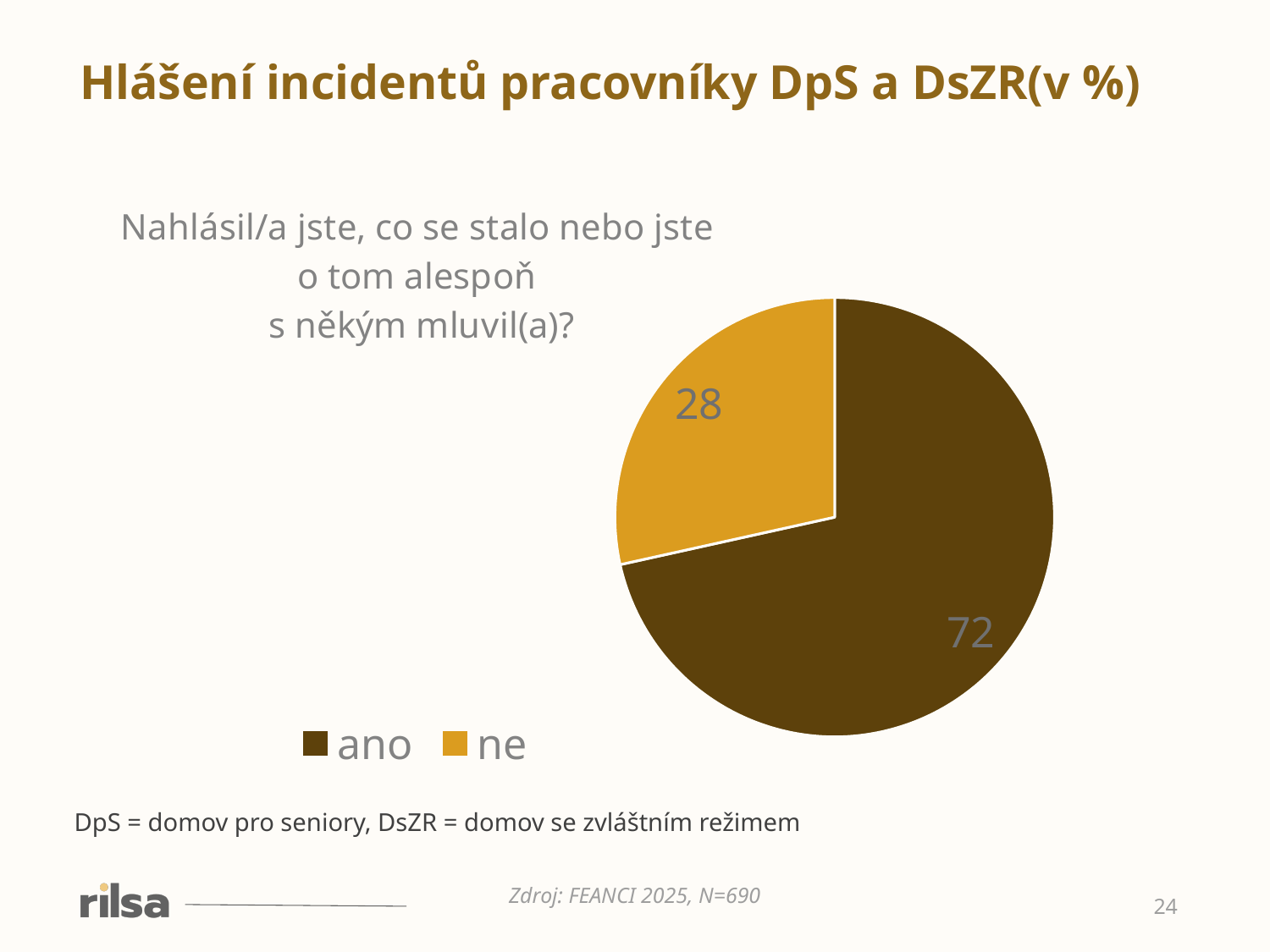
What share of the pie does the "ne" slice represent? 28% Which colour represents "ne" in the pie chart? orange/gold What is the title of the slide containing the pie chart? Hlášení incidentů pracovníky DpS a DsZR(v %) What value is shown for the "ano" slice of the pie chart? 72 What kind of chart is shown on the slide? pie chart What value is shown for the "ne" slice of the pie chart? 28 Which category has the smallest slice in the pie chart? ne How many slices does the pie chart have? 2 How many entries does the legend of the pie chart list? 2 Which category has the largest slice in the pie chart? ano Which is larger in the pie chart, "ano" or "ne"? ano What is the difference between the "ano" and "ne" values in the pie chart? 44